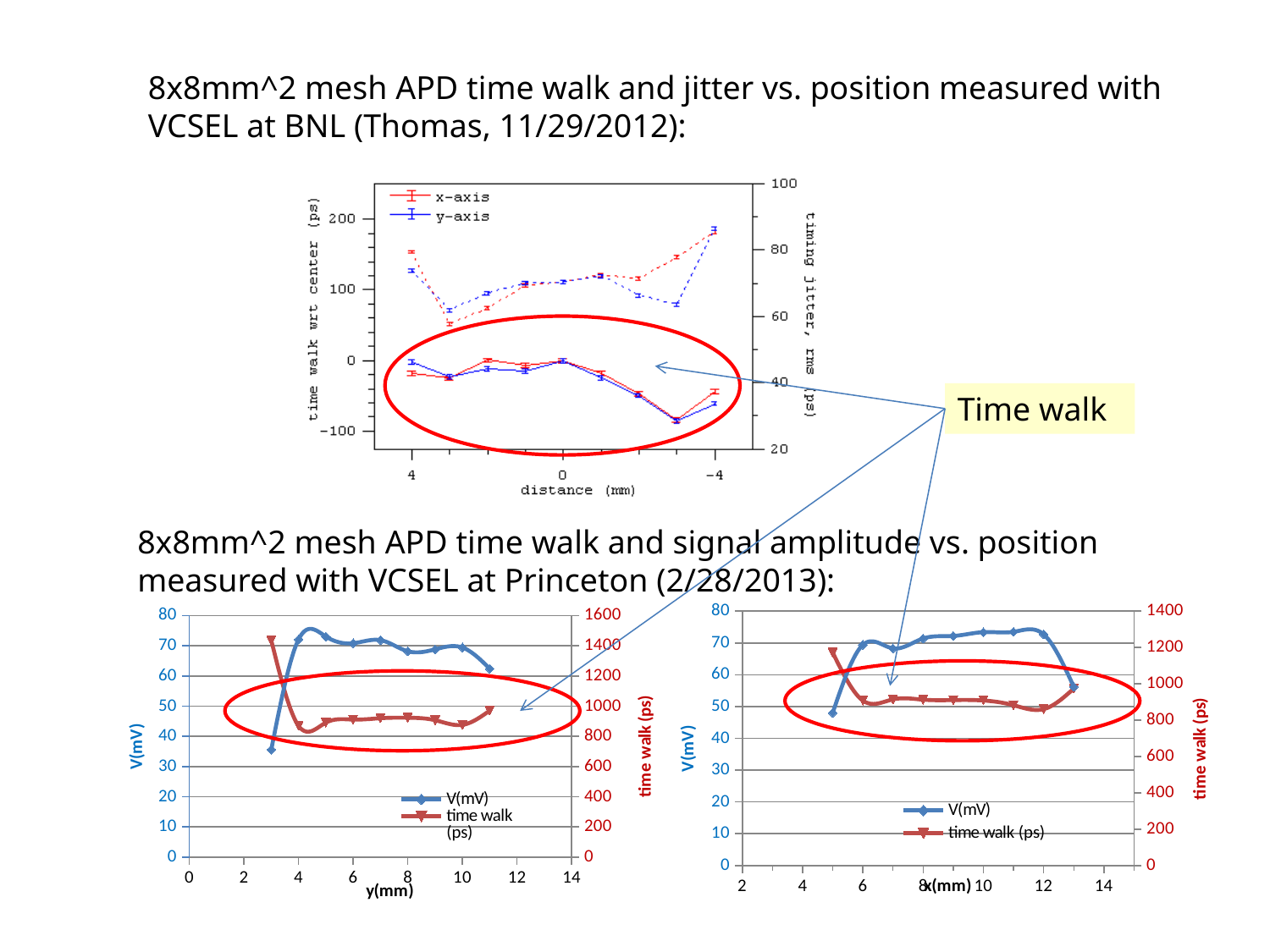
What is the label of the right-hand vertical axis in the bottom-left chart? time walk (ps) How many series does the legend list in the bottom-right chart with the x axis labelled x(mm)? 2 In the bottom-left chart (y(mm) on the x axis), is the time walk (ps) value at y = 6 greater or less than 1000? less What kind of chart is the bottom-left chart with the x axis labelled y(mm)? line chart In the bottom-right chart (x(mm) on the x axis), is the time walk (ps) value at x = 12 greater or less than 1000? less How many series does the legend list in the top chart with the x axis labelled distance (mm)? 2 In the bottom-right chart (x(mm) on the x axis), is the time walk (ps) value at x = 5 greater or less than 1000? greater What are the two legend entries in the top chart? x-axis and y-axis In the bottom-right chart (x(mm) on the x axis), does the V(mV) series rise or fall between x = 5 and x = 10? rise